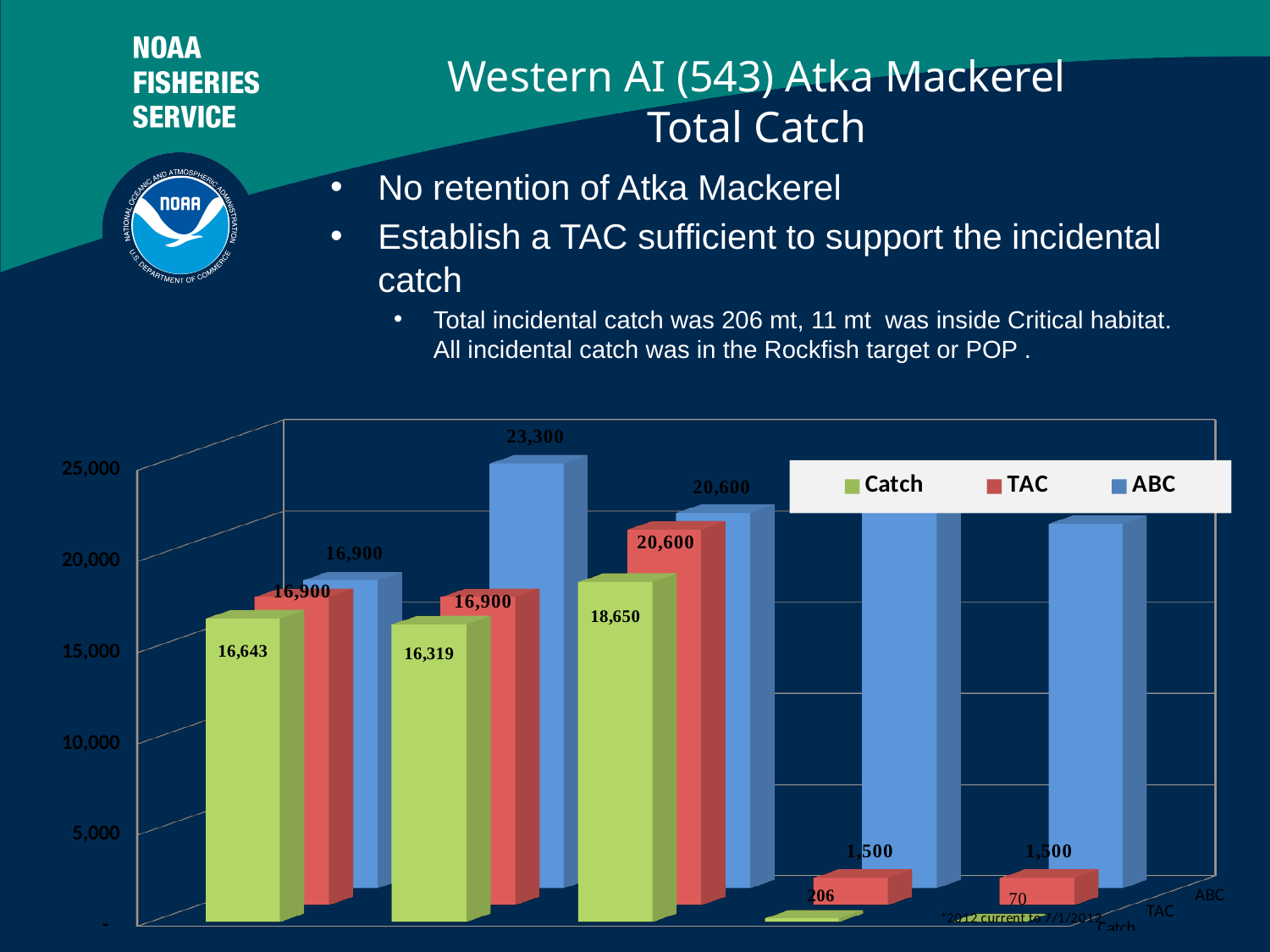
What is the TAC value for the third group of bars? 20,600 What is the Catch value for the first group of bars? 16,643 What is the ABC value for the second group of bars? 23,300 What colour represents the ABC series in the chart? blue How many series does the chart legend list? 3 Which series are listed in the chart legend? Catch, TAC, ABC Which group of bars has the highest Catch value? the third group (18,650) How many groups of bars are plotted in the chart? 5 Is the ABC value for the fifth group of bars greater or less than 15,000? greater What type of chart is shown on the slide? bar chart What is the difference between the TAC and the Catch in the third group of bars? 1,950